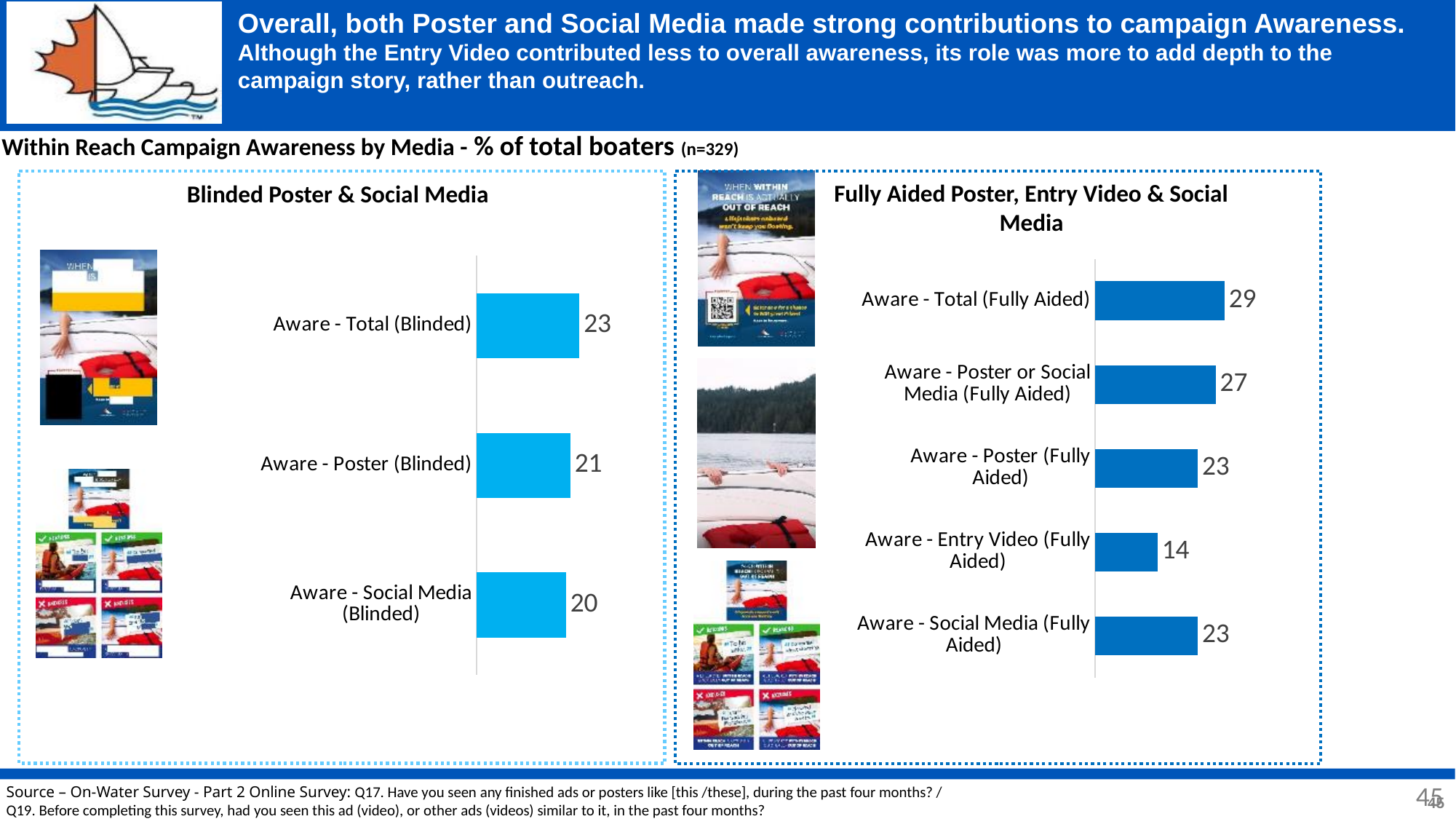
How many categories are shown in the 'Fully Aided Poster, Entry Video & Social Media' chart? 5 What type of chart is the 'Blinded Poster & Social Media' chart? Bar chart In the 'Blinded Poster & Social Media' chart, what is the value for Aware - Total (Blinded)? 23 In the 'Fully Aided Poster, Entry Video & Social Media' chart, what is the value for Aware - Poster or Social Media (Fully Aided)? 27 In the 'Blinded Poster & Social Media' chart, what is the value for Aware - Social Media (Blinded)? 20 In the 'Blinded Poster & Social Media' chart, what is the difference between Aware - Total (Blinded) and Aware - Poster (Blinded)? 2 In the 'Fully Aided Poster, Entry Video & Social Media' chart, which category has the lowest value? Aware - Entry Video (Fully Aided) In the 'Fully Aided Poster, Entry Video & Social Media' chart, what is the value for Aware - Entry Video (Fully Aided)? 14 In the 'Fully Aided Poster, Entry Video & Social Media' chart, which category has the highest value? Aware - Total (Fully Aided) Which is larger: Aware - Poster (Blinded) in the left chart or Aware - Poster (Fully Aided) in the right chart? Aware - Poster (Fully Aided) In the 'Blinded Poster & Social Media' chart, which category has the lowest value? Aware - Social Media (Blinded) In the 'Fully Aided Poster, Entry Video & Social Media' chart, what is the difference between Aware - Total (Fully Aided) and Aware - Entry Video (Fully Aided)? 15